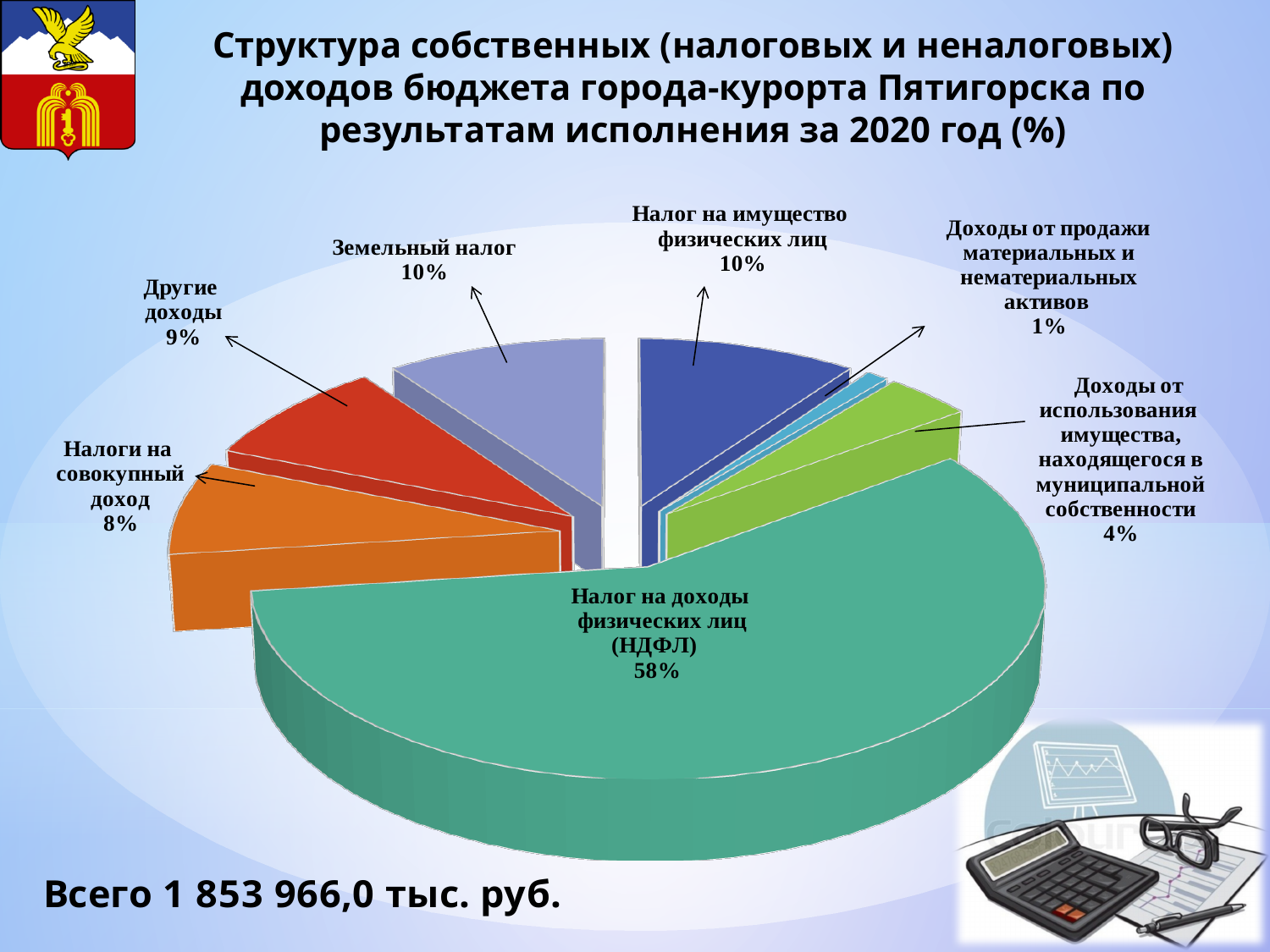
What kind of chart is shown on the slide? pie chart Which is larger: the share of "Другие доходы" or the share of "Доходы от использования имущества, находящегося в муниципальной собственности"? Другие доходы How many slices does the pie chart have? 7 What is the value shown for "Налоги на совокупный доход"? 8% Which category has the largest slice of the pie? Налог на доходы физических лиц (НДФЛ) What is the value shown for "Доходы от использования имущества, находящегося в муниципальной собственности"? 4% What is the difference between the shares of "Другие доходы" and "Налоги на совокупный доход"? 1% Which category has the smallest slice of the pie? Доходы от продажи материальных и нематериальных активов What total amount in thousand rubles is stated below the chart? 1 853 966,0 тыс. руб. What is the value shown for "Земельный налог"? 10% What share of the pie does "Налог на доходы физических лиц (НДФЛ)" have? 58% What is the difference between the share of "Налог на доходы физических лиц (НДФЛ)" and the share of "Налог на имущество физических лиц"? 48%